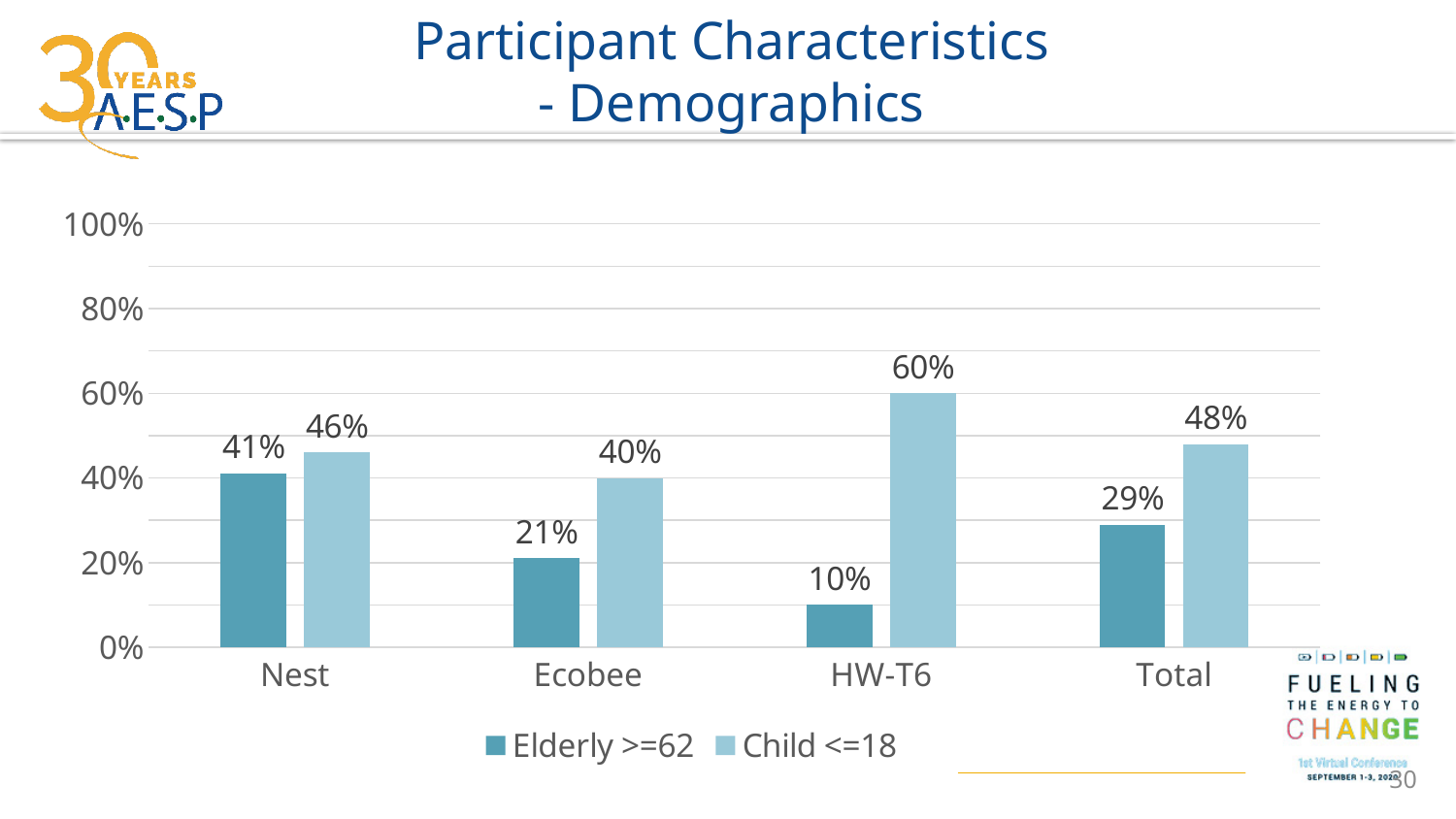
What is the value for Elderly >=62 in the Total category? 29% What is the difference between the Child <=18 and Elderly >=62 values for Ecobee? 19% Does the Elderly >=62 value rise or fall from Nest to HW-T6? Fall How many series does the legend list? 2 How many categories are shown on the x axis? 4 Which is larger for Nest: the Elderly >=62 value or the Child <=18 value? Child <=18 What kind of chart is shown on the slide? Bar chart What is the title of the slide? Participant Characteristics - Demographics Which category has the highest Child <=18 value? HW-T6 What is the value for Elderly >=62 in the Nest category? 41% What is the value for Child <=18 in the HW-T6 category? 60% Which category has the lowest Elderly >=62 value? HW-T6